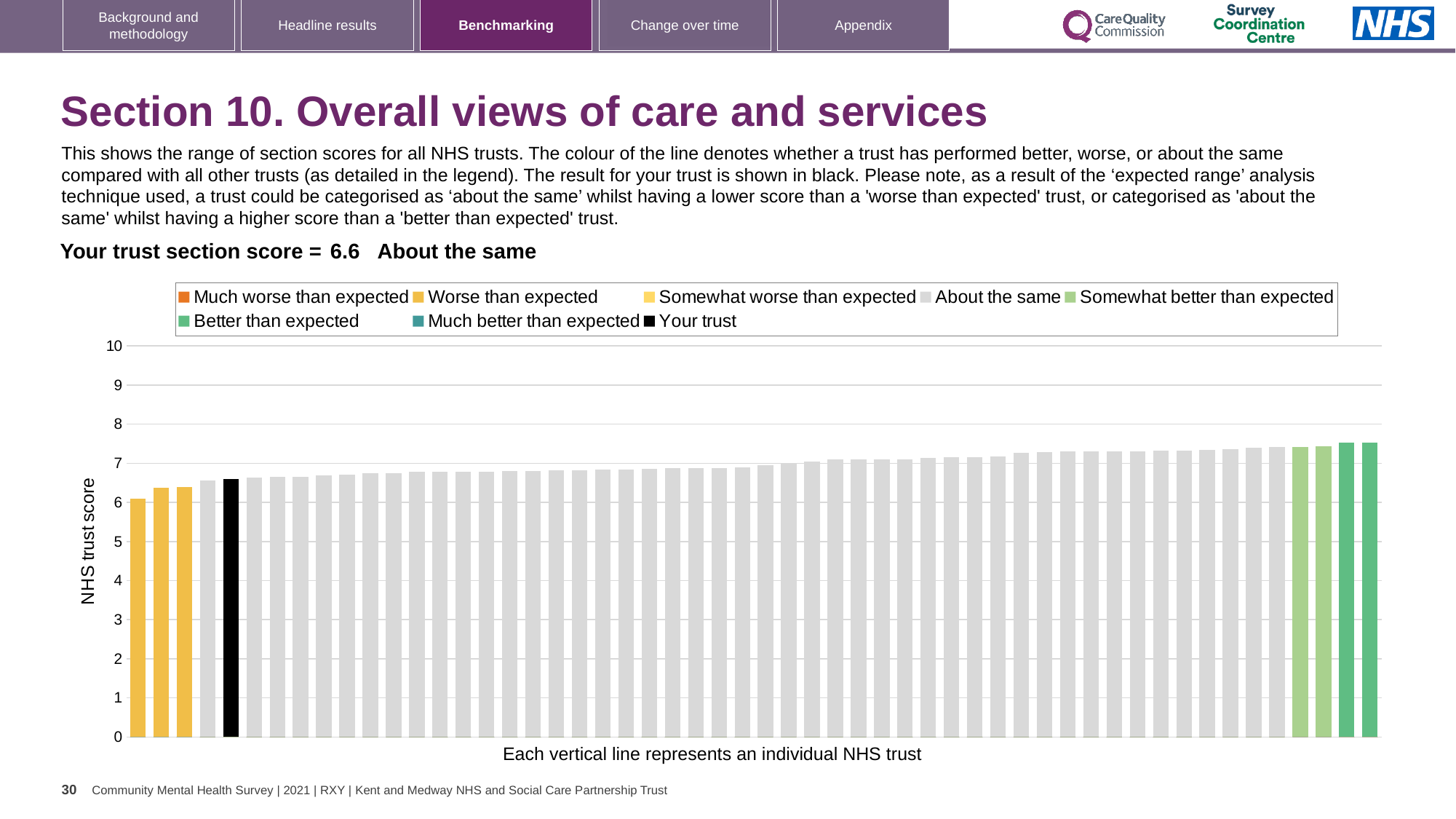
How many entries does the chart legend list? 8 Which is taller: the black 'Your trust' bar or the leftmost bar? Your trust Which performance category is the trust's section score assigned to? About the same Is the value of the black 'Your trust' bar greater or less than 5? greater What kind of chart is shown on the slide? Bar chart Is the value of the tallest bar greater or less than 8? less How many bars are coloured as 'Worse than expected'? 3 Is the value of the tallest bar greater or less than 7? greater How many bars are coloured as 'Much worse than expected'? 0 How many bars are coloured as 'Better than expected'? 2 What is the trust section score shown on the slide? 6.6 Do the bar values rise or fall from left to right along the x axis? Rise